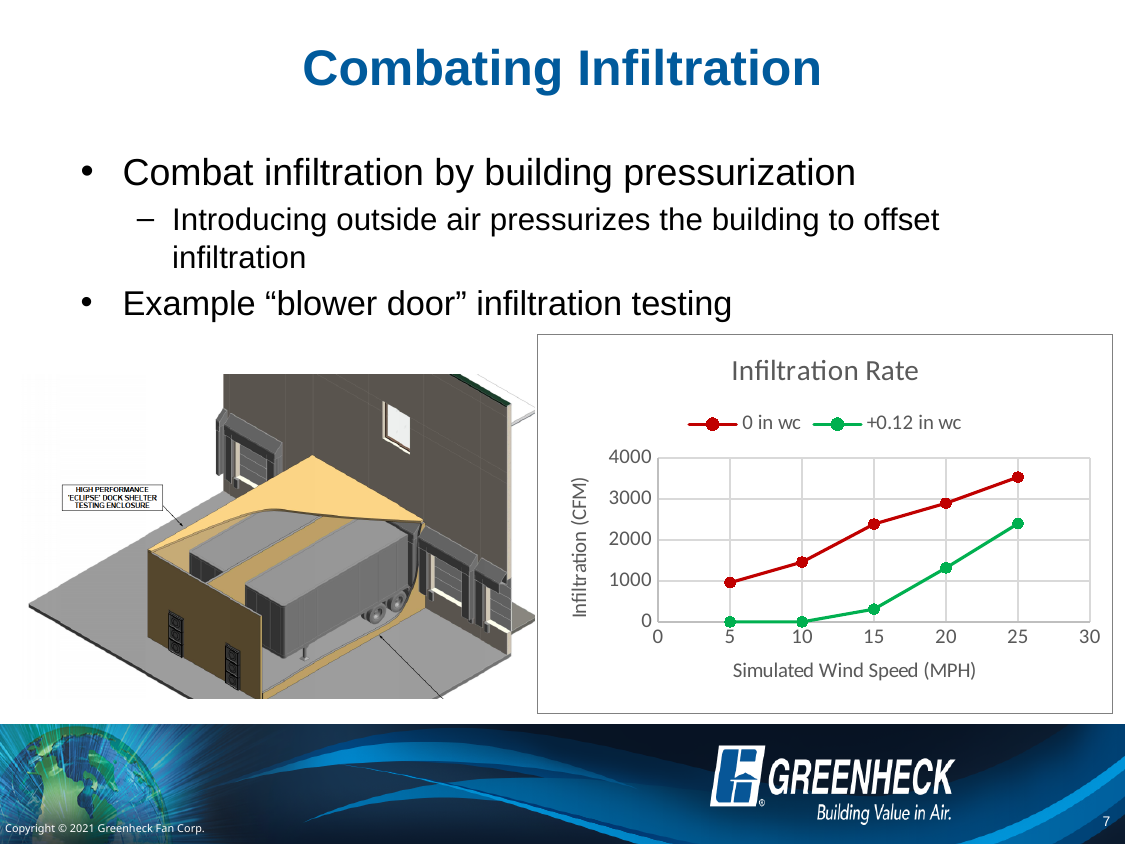
In the Infiltration Rate chart, is the +0.12 in wc value at 20 MPH greater or less than 1000? greater In the Infiltration Rate chart, is the 0 in wc value at 15 MPH greater or less than 2000? greater What are the two series named in the legend of the Infiltration Rate chart? 0 in wc and +0.12 in wc In the Infiltration Rate chart, does infiltration for the 0 in wc series rise or fall as wind speed increases? rise In the Infiltration Rate chart, at which wind speed is the +0.12 in wc series highest? 25 What is the x-axis label of the Infiltration Rate chart? Simulated Wind Speed (MPH) In the Infiltration Rate chart, is the +0.12 in wc value at 15 MPH greater or less than 1000? less What kind of chart is the Infiltration Rate chart? line chart How many series does the legend of the Infiltration Rate chart list? 2 How many data points are plotted for the 0 in wc series in the Infiltration Rate chart? 5 In the Infiltration Rate chart, which series has the higher infiltration at 20 MPH, 0 in wc or +0.12 in wc? 0 in wc